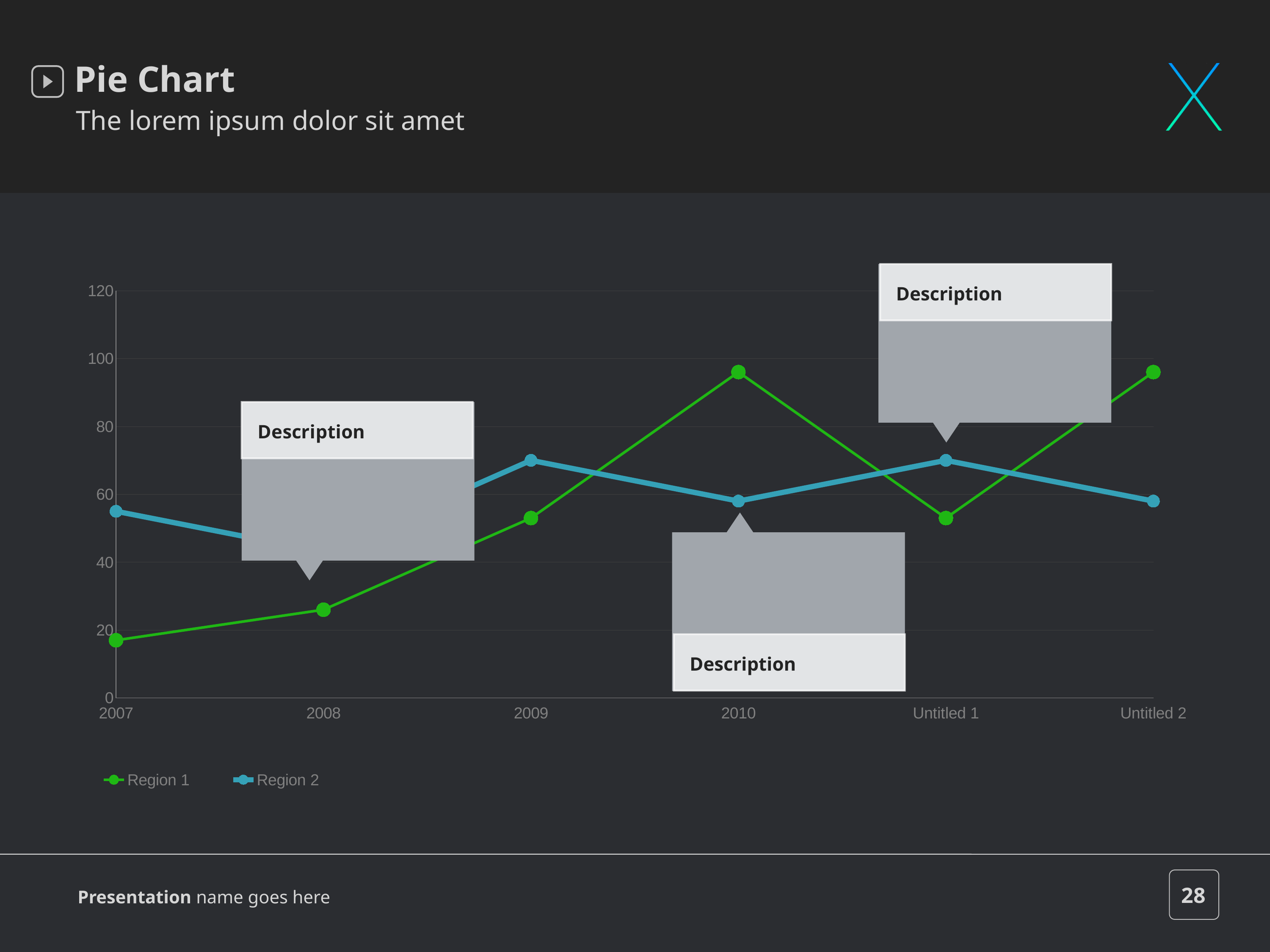
What is the title of the slide containing the chart? Pie Chart Which category has the lowest value for Region 1? 2007 What kind of chart is shown on the slide? line chart Is the value for Region 2 in 2007 greater or less than 60? less In 2007, which series has the larger value, Region 1 or Region 2? Region 2 How many categories are shown on the x axis? 6 Is the value for Region 2 in 2009 greater or less than 60? greater In 2010, which series has the larger value, Region 1 or Region 2? Region 1 Is the value for Region 1 in 2010 greater or less than 80? greater How many series does the legend list? 2 Does the Region 1 line rise or fall from 2007 to 2010? rise